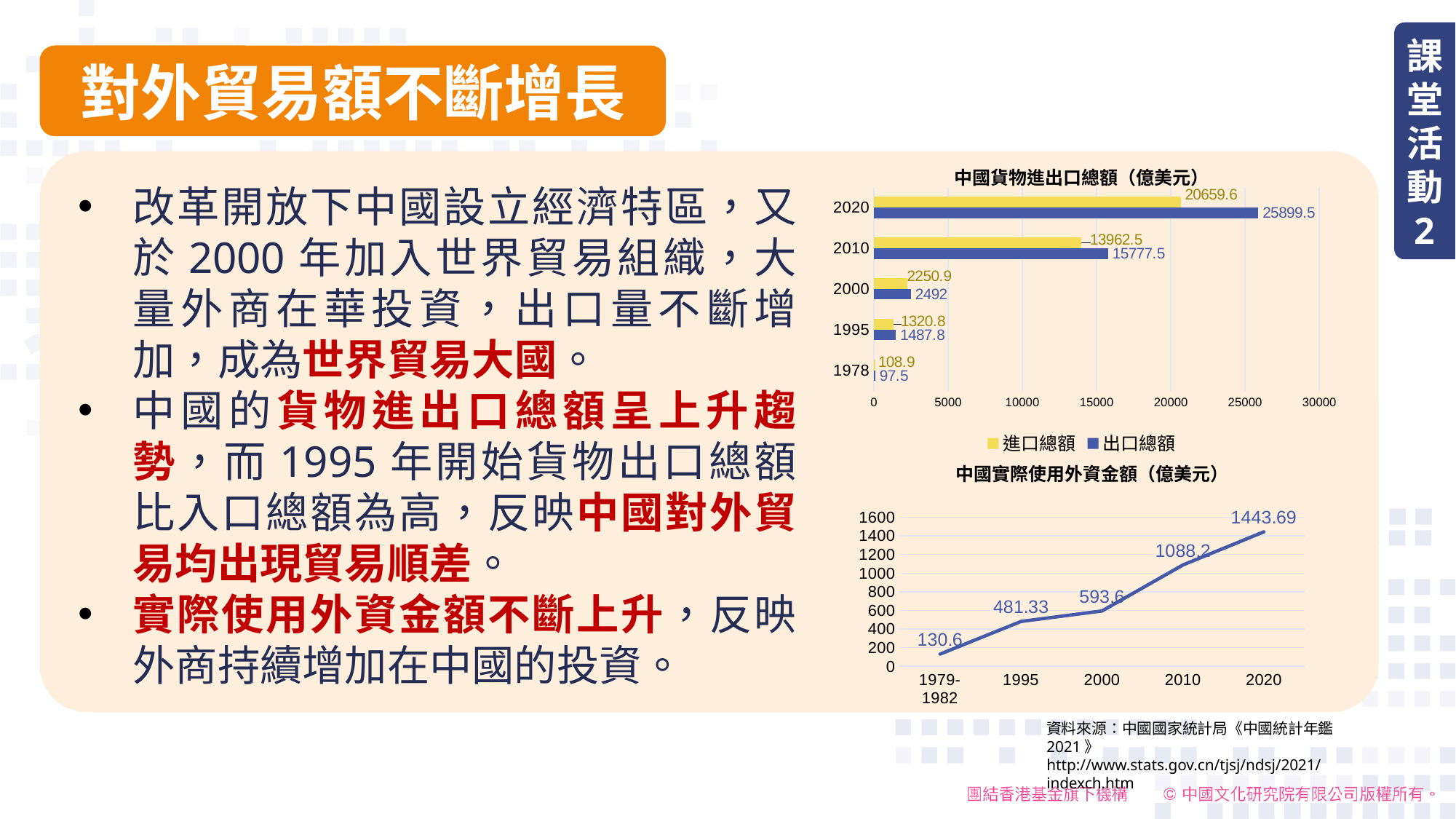
What kind of chart is the chart titled 中國貨物進出口總額（億美元）? Bar chart In the chart titled 中國實際使用外資金額（億美元）, what is the value for 2010? 1088.2 In the chart titled 中國貨物進出口總額（億美元）, which is larger in 1978, 進口總額 or 出口總額? 進口總額 In the chart titled 中國貨物進出口總額（億美元）, what is the 進口總額 value for 2010? 13962.5 In the chart titled 中國貨物進出口總額（億美元）, what is the difference between 出口總額 and 進口總額 in 2000? 241.1 In the chart titled 中國貨物進出口總額（億美元）, which year has the highest 出口總額? 2020 How many data points are plotted in the chart titled 中國實際使用外資金額（億美元）? 5 In the chart titled 中國貨物進出口總額（億美元）, what is the 進口總額 value for 1978? 108.9 In the chart titled 中國實際使用外資金額（億美元）, do the values rise or fall from 1979-1982 to 2020? Rise In the chart titled 中國貨物進出口總額（億美元）, what is the 出口總額 value for 2020? 25899.5 In the chart titled 中國實際使用外資金額（億美元）, what is the value for 1979-1982? 130.6 How many series does the legend of the chart titled 中國貨物進出口總額（億美元）list? 2